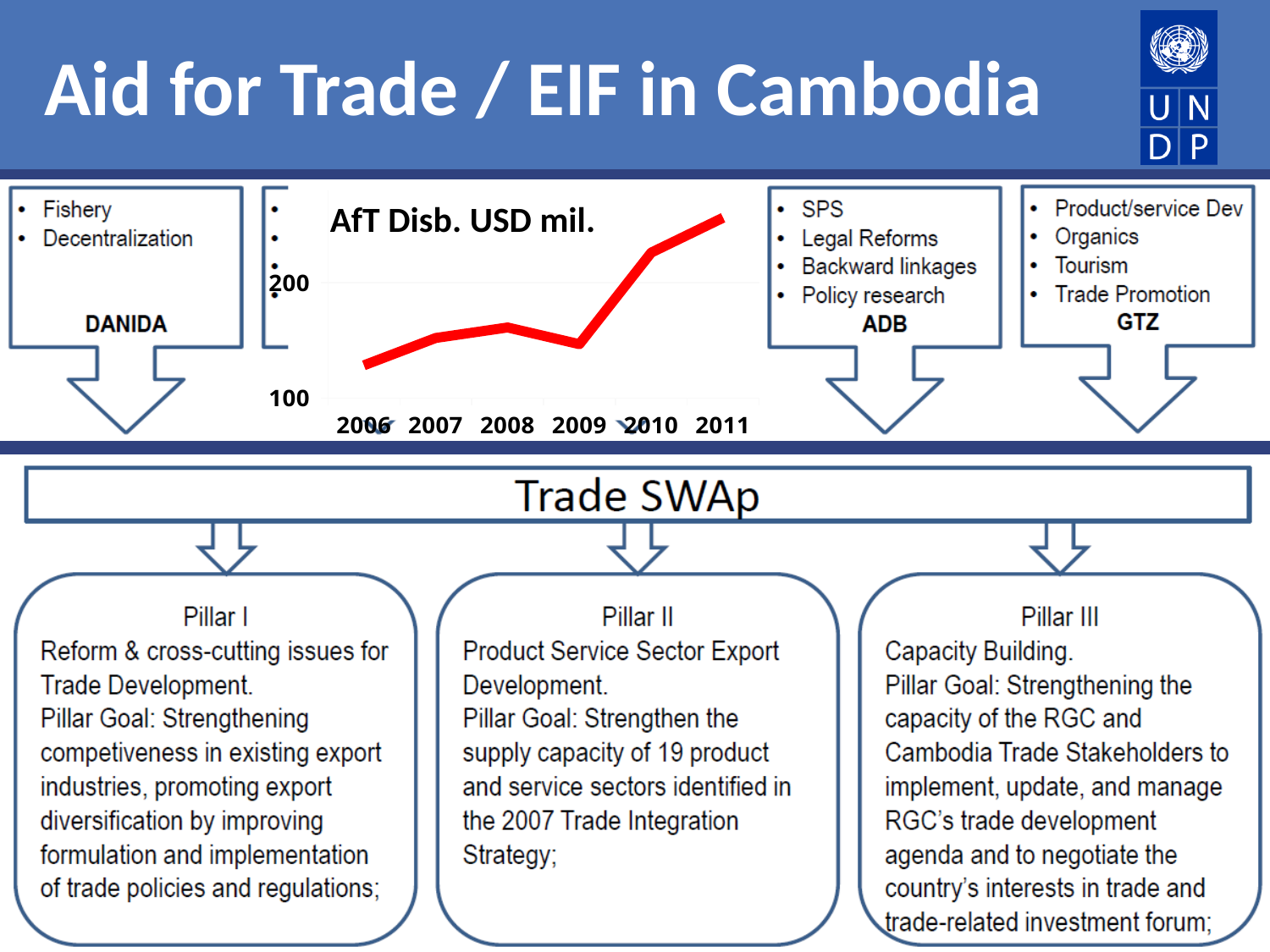
Which year has the larger value, 2010 or 2009? 2010 Which year has the lowest AfT disbursement value? 2006 Overall, do the values rise or fall from 2006 to 2011? rise What kind of chart is shown on the slide? line chart Is the value for 2006 greater or less than 200? less Is the value for 2009 greater or less than 200? less What is the title of the chart? AfT Disb. USD mil. Is the value for 2008 greater or less than 100? greater How many years are plotted on the x axis of the chart? 6 Which year has the highest AfT disbursement value? 2011